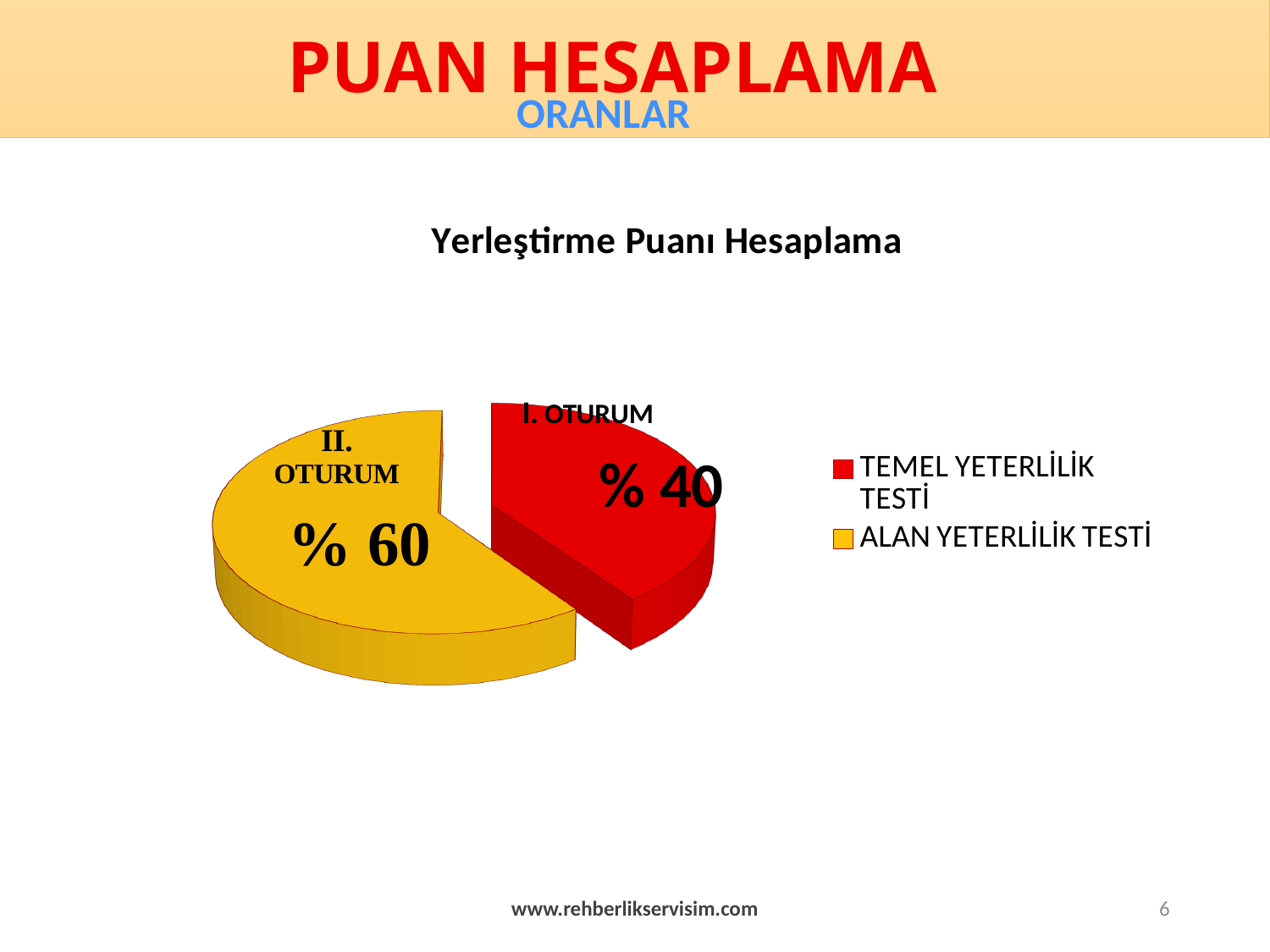
Which slice is the smallest? I. OTURUM Which slice is the largest? II. OTURUM What is the difference in percentage points between the II. OTURUM and I. OTURUM slices? 20 How many slices does the pie chart have? 2 Which legend entry is shown in red? TEMEL YETERLİLİK TESTİ What share of the pie does the II. OTURUM slice represent? % 60 What share of the pie does the I. OTURUM slice represent? % 40 Which is larger, the I. OTURUM slice or the II. OTURUM slice? II. OTURUM What kind of chart is shown on the slide? pie chart How many entries does the legend list? 2 What is the chart's title? Yerleştirme Puanı Hesaplama